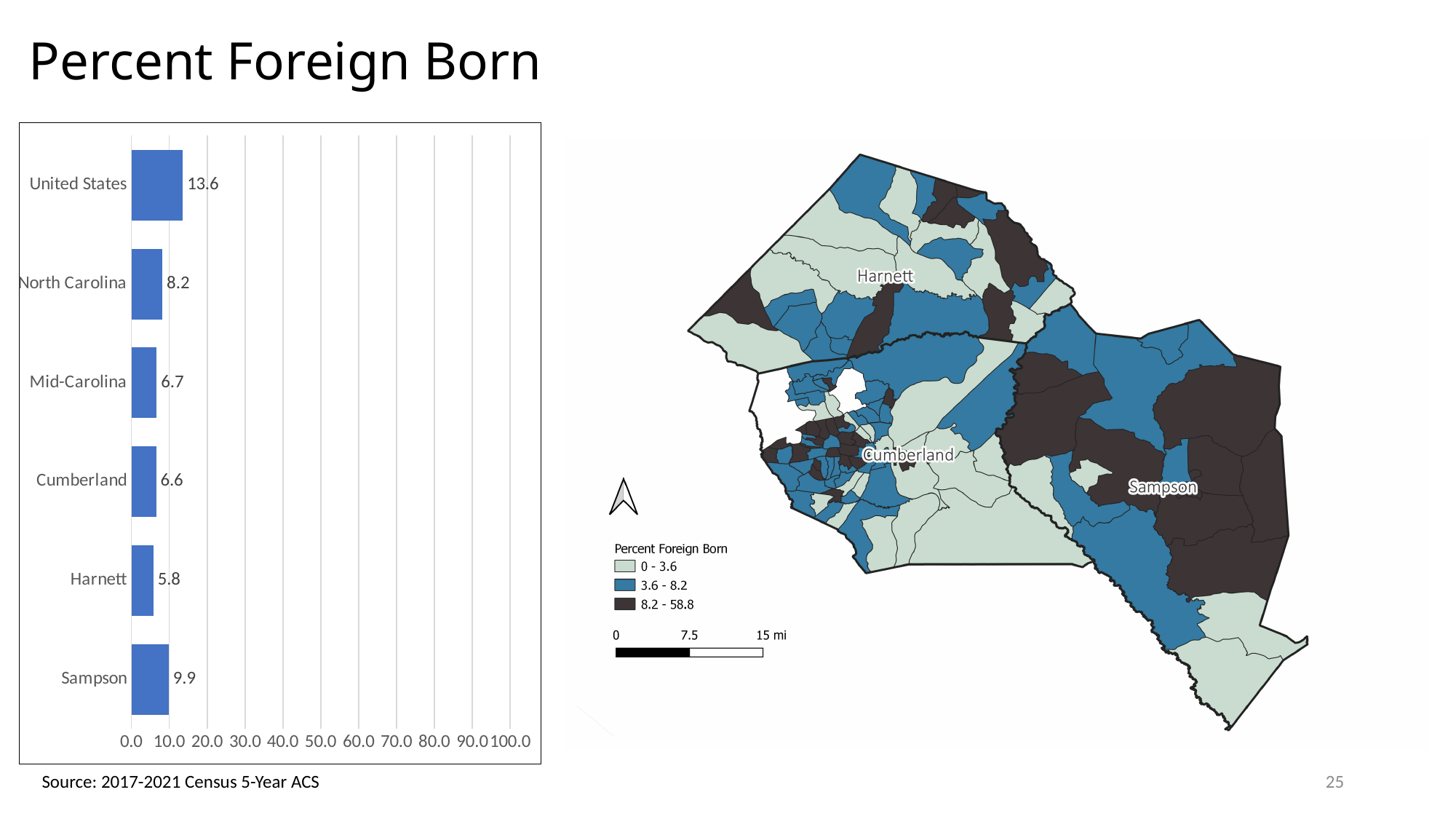
What is the highest value on the x axis of the bar chart? 100.0 Which category has the highest value in the bar chart? United States Which category has the lowest value in the bar chart? Harnett What is the percent foreign born value for Harnett in the bar chart? 5.8 Which is larger in the bar chart, the value for Sampson or the value for Cumberland? Sampson What is the difference between the Cumberland value and the Harnett value in the bar chart? 0.8 Is the value for Mid-Carolina in the bar chart greater or less than 10.0? less What is the difference between the United States value and the North Carolina value in the bar chart? 5.4 What kind of chart is shown on the left of the slide? bar chart How many categories are shown in the bar chart? 6 What is the percent foreign born value for Sampson in the bar chart? 9.9 What is the percent foreign born value for the United States in the bar chart? 13.6